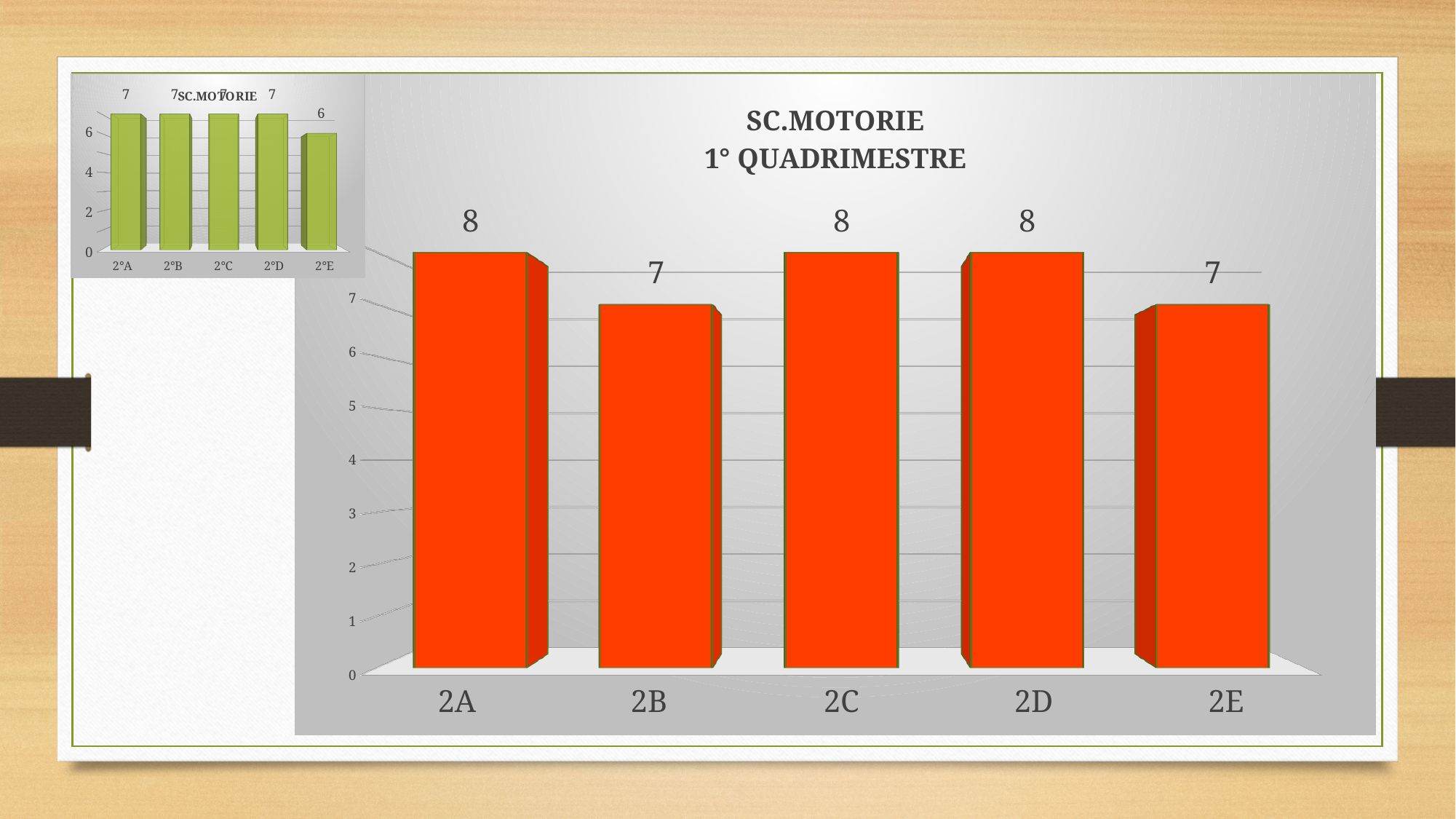
In the large chart titled SC.MOTORIE 1° QUADRIMESTRE, which category has the lowest value, 2B or 2C? 2B In the large chart titled SC.MOTORIE 1° QUADRIMESTRE, is the value for 2D greater or less than 5? greater In the large chart titled SC.MOTORIE 1° QUADRIMESTRE, what is the difference between the values for 2C and 2E? 1 In the large chart titled SC.MOTORIE 1° QUADRIMESTRE, what is the value for 2B? 7 In the large chart titled SC.MOTORIE 1° QUADRIMESTRE, how many categories are shown on the x axis? 5 In the large chart titled SC.MOTORIE 1° QUADRIMESTRE, what is the value for 2E? 7 In the small chart in the top-left corner titled SC.MOTORIE, which category has the lowest value? 2°E In the large chart titled SC.MOTORIE 1° QUADRIMESTRE, what is the value for 2A? 8 In the small chart in the top-left corner titled SC.MOTORIE, what is the difference between the values for 2°D and 2°E? 1 In the small chart in the top-left corner titled SC.MOTORIE, what is the value for 2°E? 6 What kind of chart is the large chart titled SC.MOTORIE 1° QUADRIMESTRE? bar chart In the small chart in the top-left corner titled SC.MOTORIE, what is the value for 2°A? 7